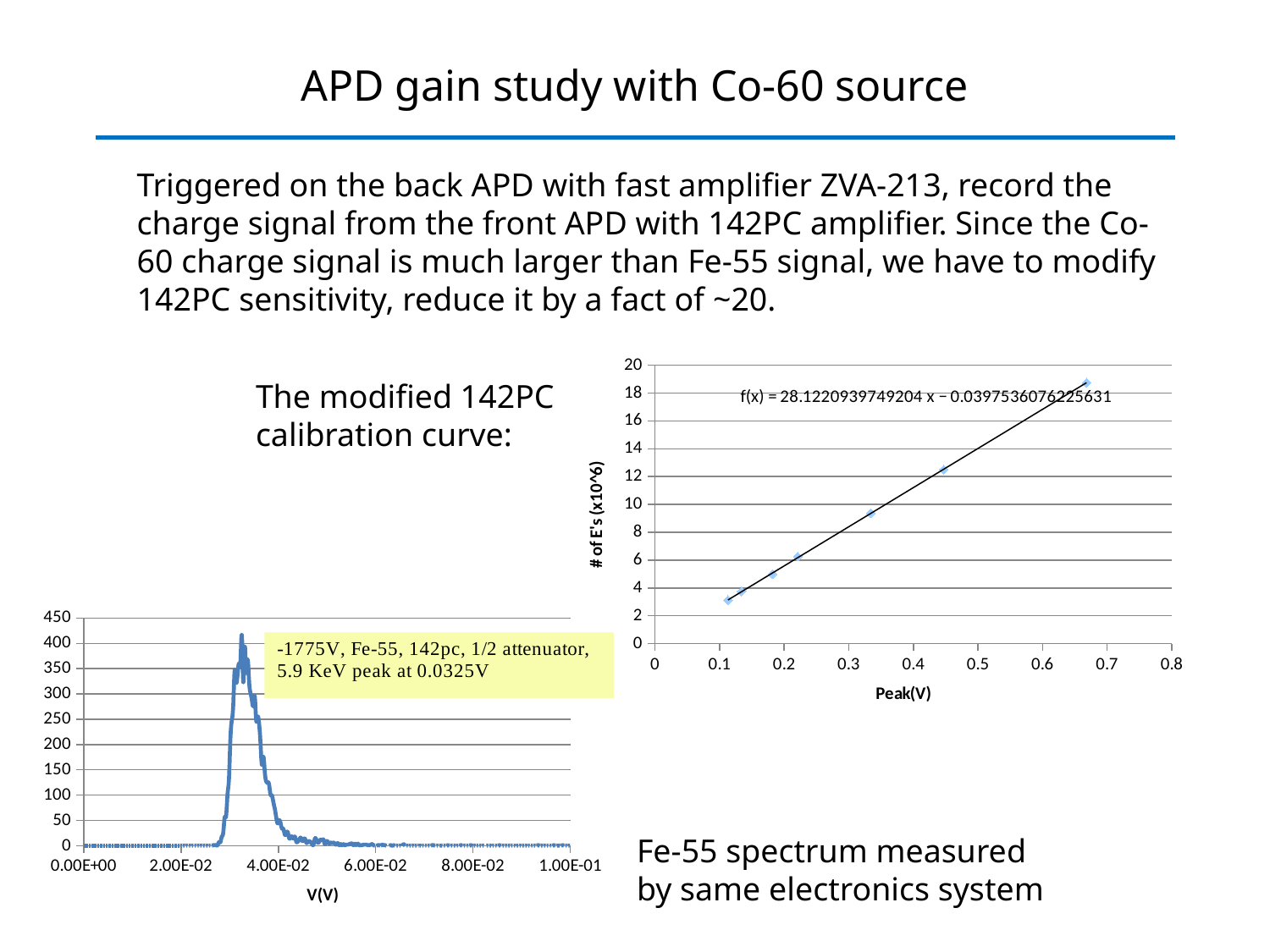
In the calibration curve chart (top right), what is the title of the y axis? # of E's (x10^6) In the calibration curve chart (top right), is the value of the data point near Peak 0.33 V greater or less than 10? less In the calibration curve chart (top right), is the value of the rightmost data point (near Peak 0.67 V) greater or less than 18? greater In the calibration curve chart (top right), what is the maximum value shown on the y axis? 20 In the calibration curve chart (top right), do the plotted values rise or fall as Peak(V) increases? rise What kind of chart is the Fe-55 spectrum chart (bottom left)? line chart In the calibration curve chart (top right), what is the slope of the fitted trendline shown in the equation? 28.1220939749204 In the calibration curve chart (top right), what is the intercept of the fitted trendline shown in the equation? −0.0397536076225631 In the Fe-55 spectrum chart (bottom left), is the peak height greater or less than 400? greater In the Fe-55 spectrum chart (bottom left), at what voltage does the annotation say the 5.9 KeV peak occurs? 0.0325V In the Fe-55 spectrum chart (bottom left), what is the label of the x axis? V(V)